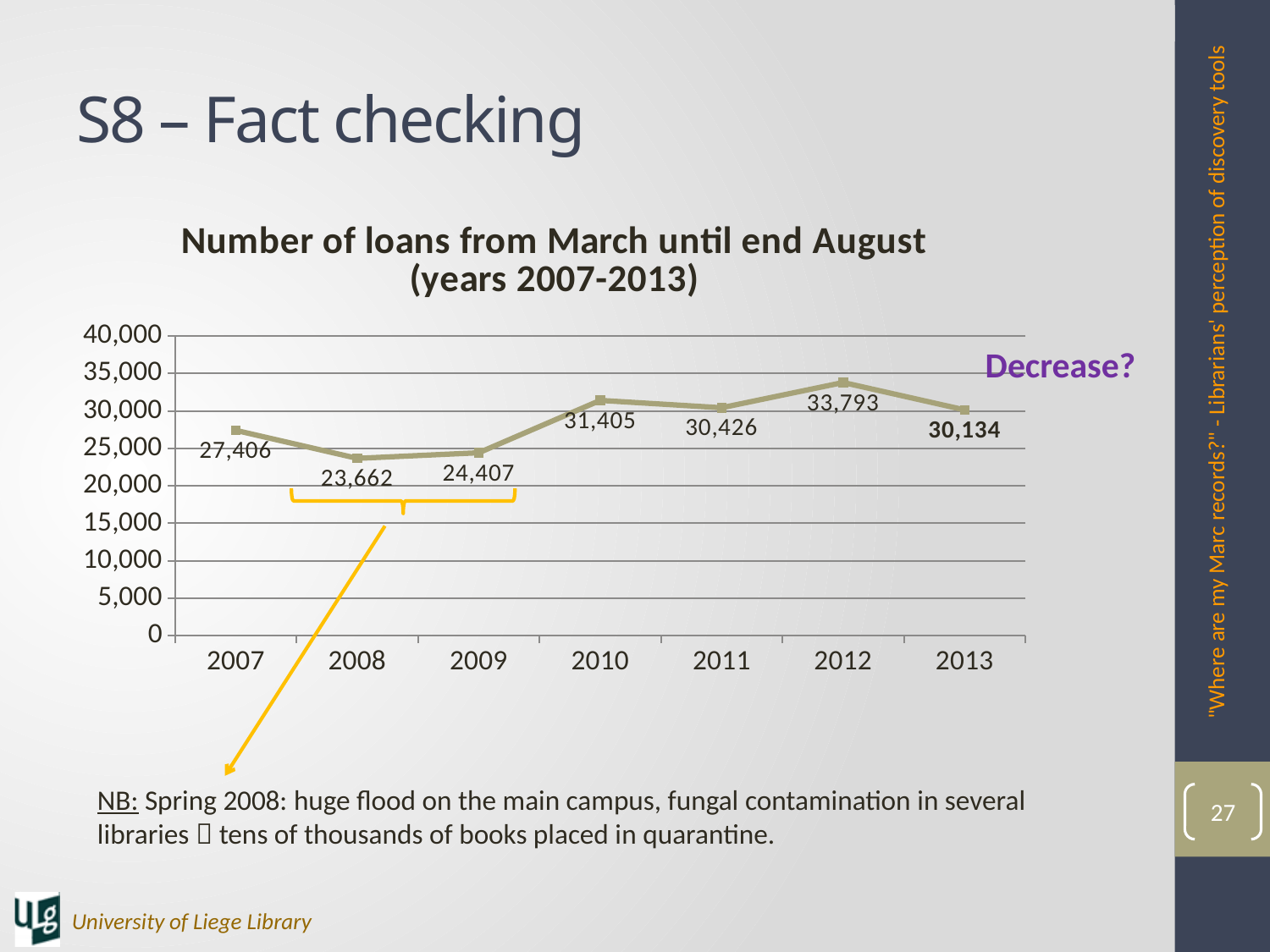
What is the number of loans for 2007? 27,406 What kind of chart is shown on the slide? line chart Which year has the lowest number of loans? 2008 Is the value for 2009 greater or less than 25,000? less What is the number of loans for 2013? 30,134 Which year has more loans, 2010 or 2011? 2010 How many years are plotted on the chart? 7 What is the number of loans for 2012? 33,793 What is the difference in loans between 2012 and 2013? 3,659 Which year has the highest number of loans? 2012 Do the loans rise or fall from 2007 to 2008? fall What is the title of the chart? Number of loans from March until end August (years 2007-2013)